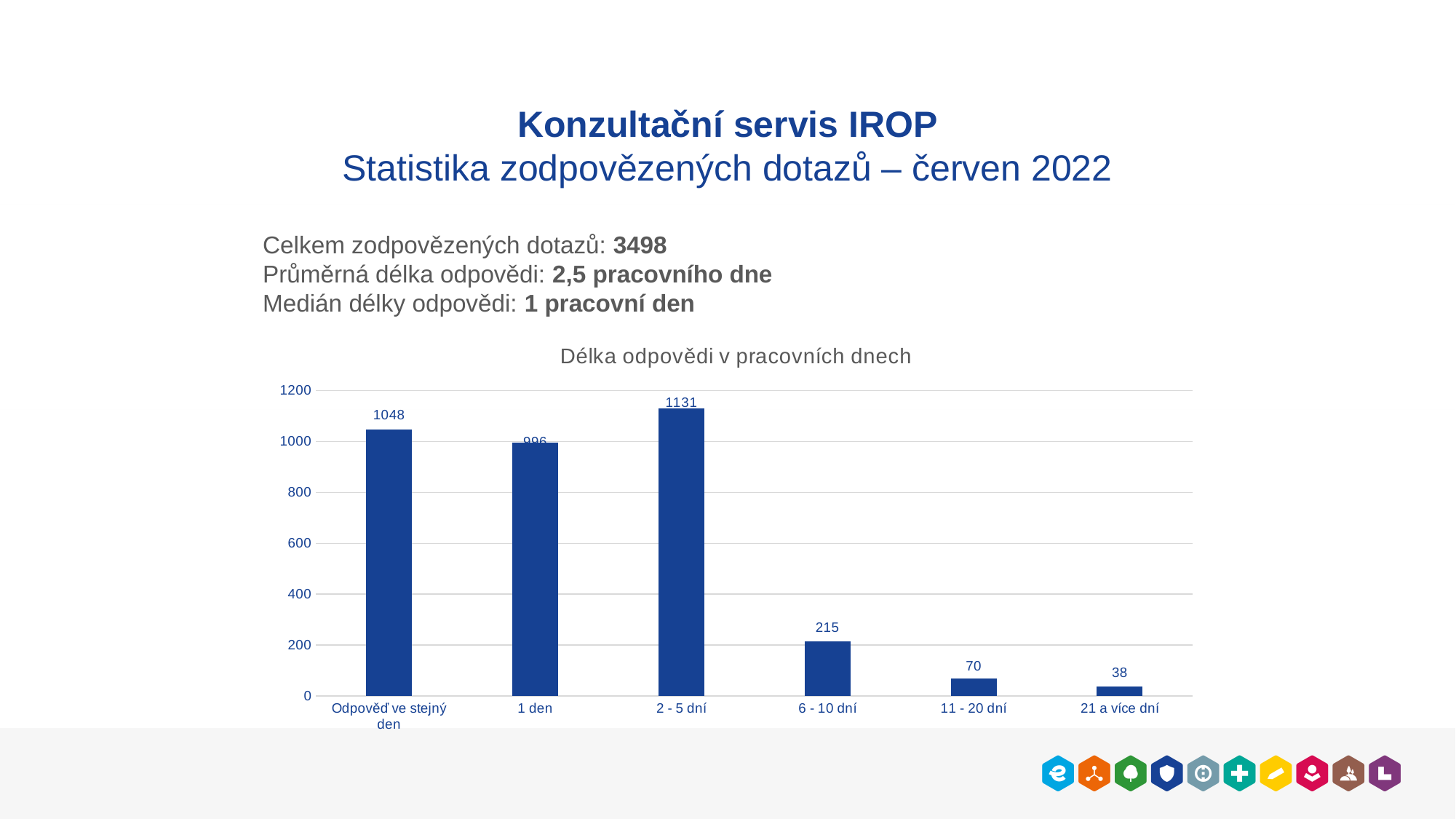
What is the value for the '6 - 10 dní' category? 215 What is the value for the '21 a více dní' category? 38 How many categories are shown on the x axis? 6 Which category has the lowest value? 21 a více dní Which category has the highest value? 2 - 5 dní What is the value for the '11 - 20 dní' category? 70 Which is larger, the value for 'Odpověď ve stejný den' or the value for '2 - 5 dní'? 2 - 5 dní What is the title of the chart? Délka odpovědi v pracovních dnech What kind of chart is shown on the slide? bar chart What is the value for the 'Odpověď ve stejný den' category? 1048 What is the difference between the values for '2 - 5 dní' and 'Odpověď ve stejný den'? 83 What is the value for the '2 - 5 dní' category? 1131